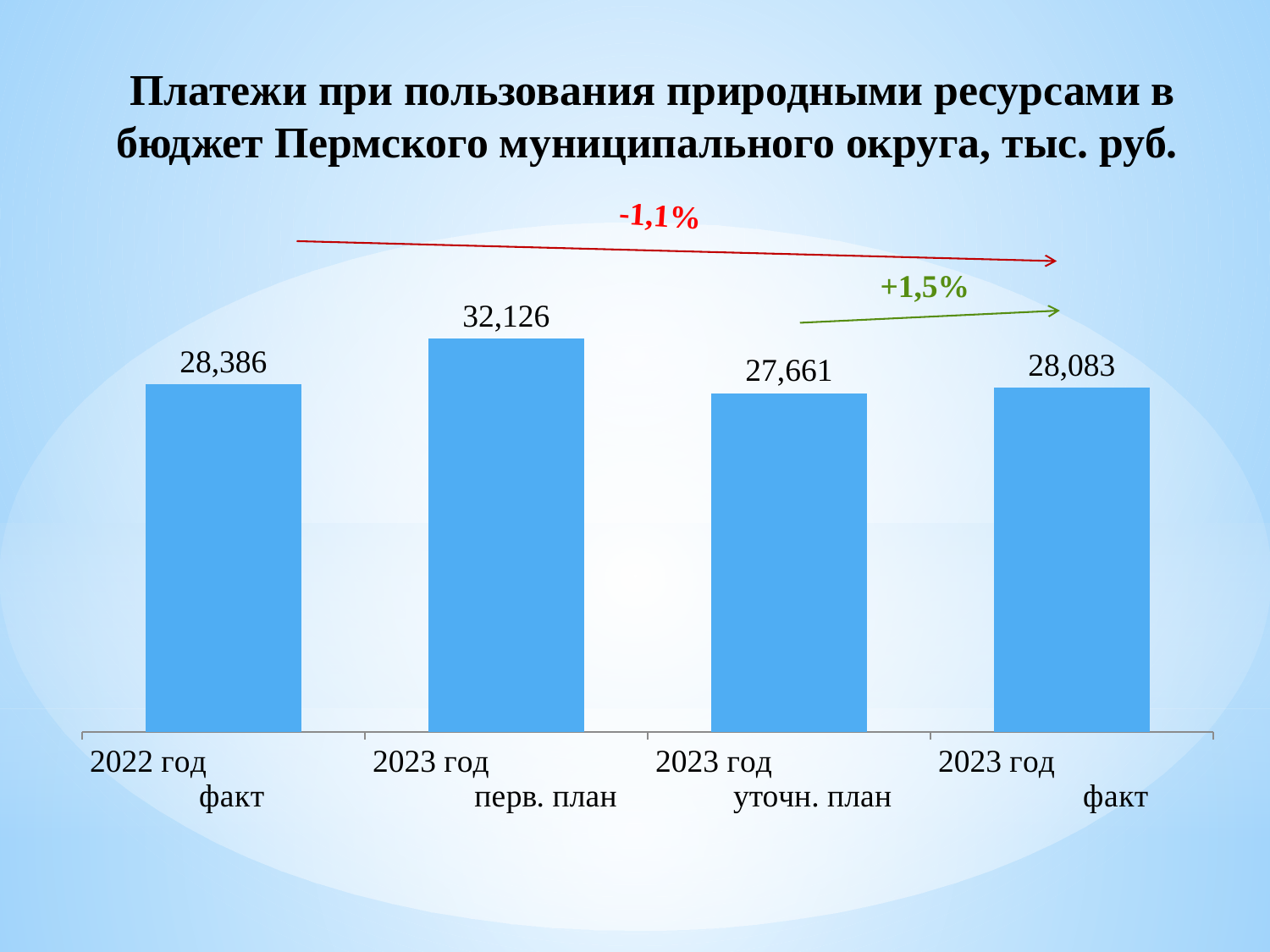
Which category has the highest value? 2023 год перв. план What percentage change is shown by the red arrow above the chart? -1,1% What is the value for 2023 год уточн. план? 27,661 What is the value for 2023 год факт? 28,083 What percentage change is shown by the green arrow above the chart? +1,5% Which is larger, the value for 2022 год факт or the value for 2023 год факт? 2022 год факт What is the difference between the values for 2023 год перв. план and 2022 год факт? 3,740 What is the value for 2022 год факт? 28,386 What kind of chart is shown on the slide? Bar chart What is the value for 2023 год перв. план? 32,126 How many bars are shown in the chart? 4 Which category has the lowest value? 2023 год уточн. план